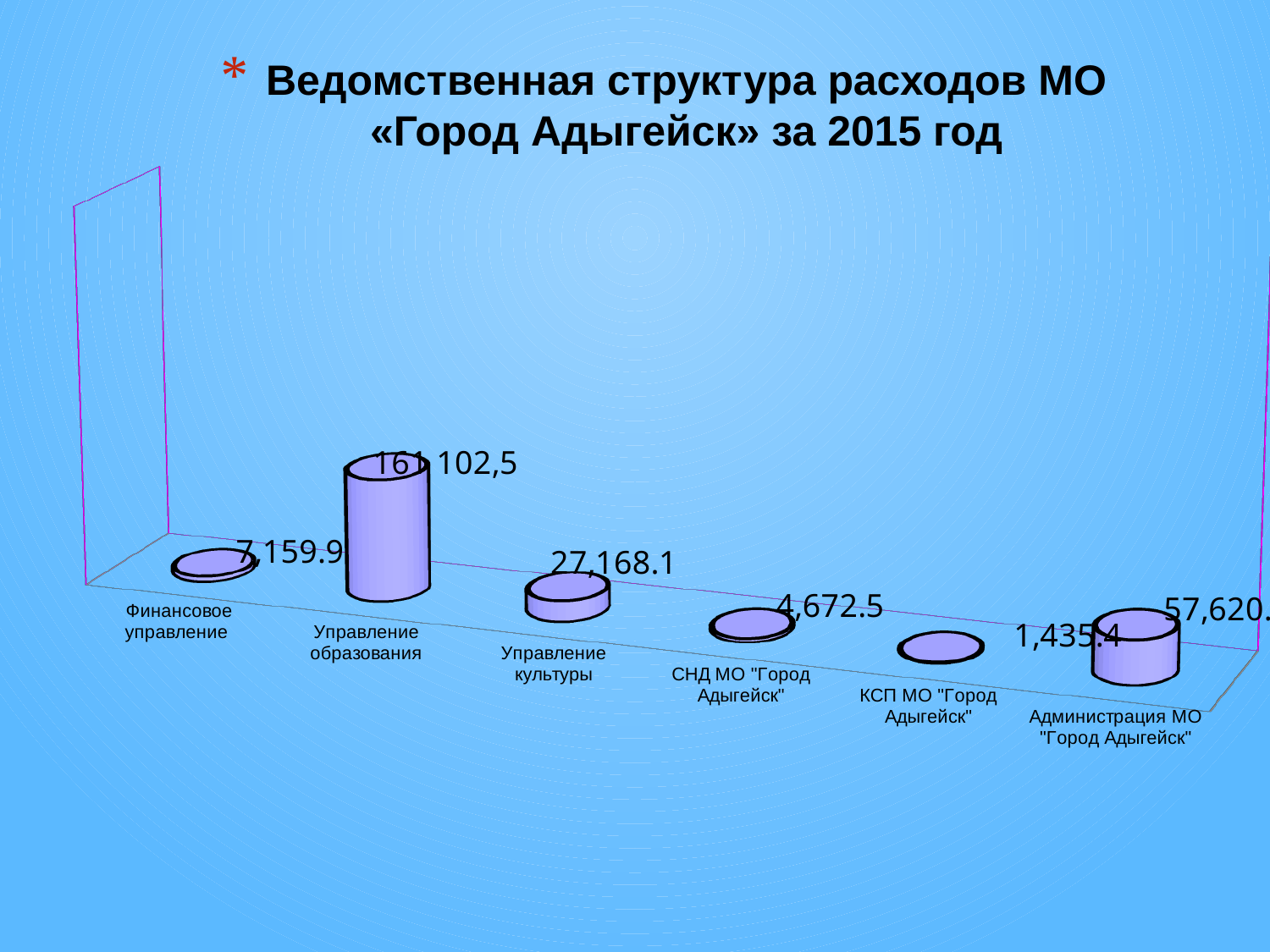
What is the difference between the values for СНД МО "Город Адыгейск" and КСП МО "Город Адыгейск"? 3,237.1 Which category has the highest value? Управление образования Which is larger: the value for Управление культуры or the value for Финансовое управление? Управление культуры How many categories are shown in the chart? 6 What is the value for СНД МО "Город Адыгейск"? 4,672.5 Which is larger: the value for Администрация МО "Город Адыгейск" or the value for Управление культуры? Администрация МО "Город Адыгейск" Which category has the lowest value? КСП МО "Город Адыгейск" What is the value for КСП МО "Город Адыгейск"? 1,435.4 What is the value for Управление культуры? 27,168.1 What is the difference between the values for Управление культуры and СНД МО "Город Адыгейск"? 22,495.6 What is the value for Финансовое управление? 7,159.9 What kind of chart is shown on the slide? Bar chart